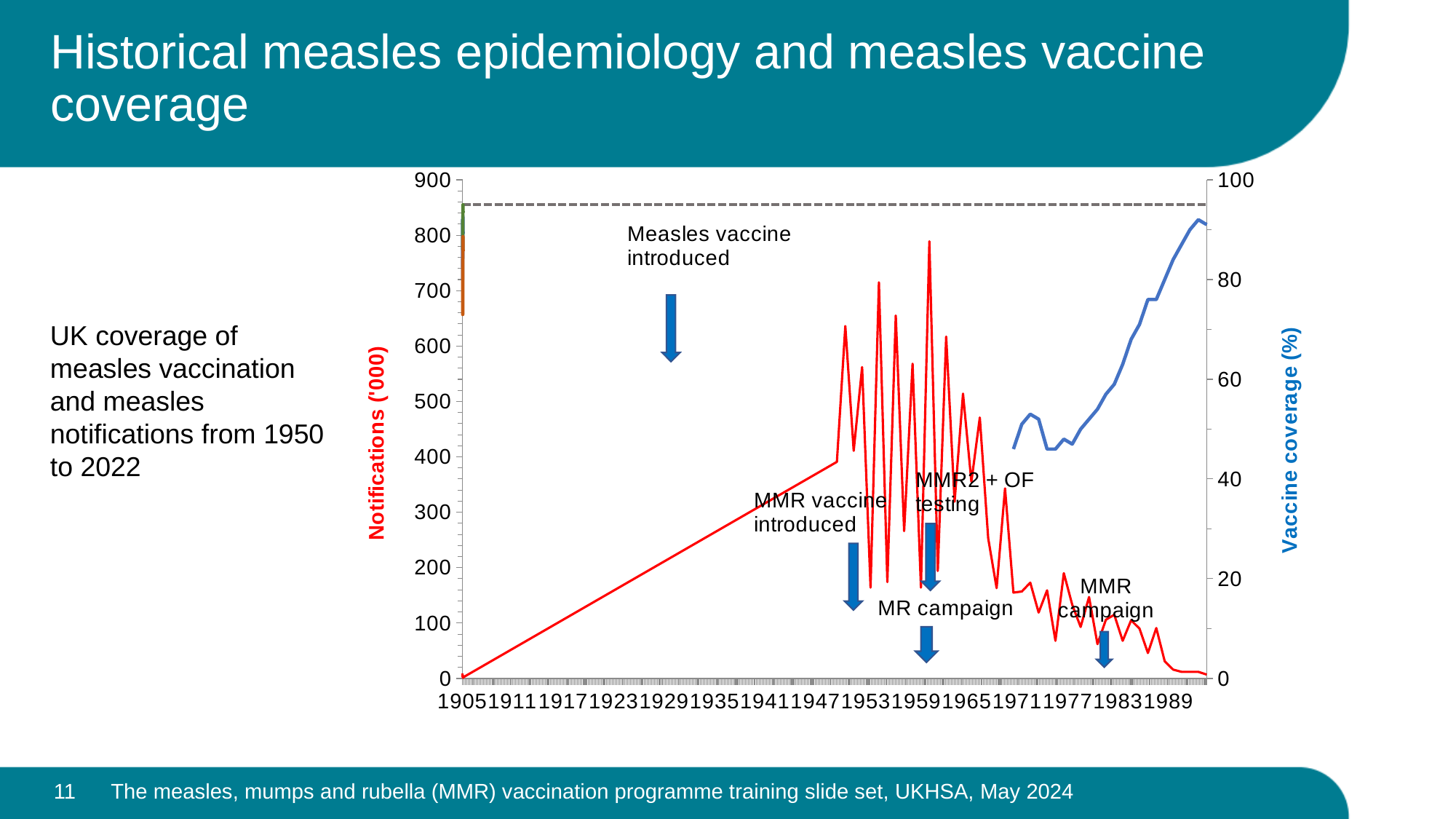
Is the value of the blue vaccine coverage line at its right-hand end greater or less than 80 on the right axis? greater Is the value of the blue vaccine coverage line at its right-hand end greater or less than 100 on the right axis? less What is the title of the left vertical axis? Notifications ('000) Is the value of the blue vaccine coverage line where it first starts greater or less than 60 on the right axis? less Does the red notifications line generally rise or fall from around 1971 to the right end of the chart? fall Does the red notifications line generally rise or fall from 1905 to around 1947? rise What kind of chart is shown on the slide? line chart Does the blue vaccine coverage line generally rise or fall from where it begins to the right end of the chart? rise What is the title of the right vertical axis? Vaccine coverage (%)